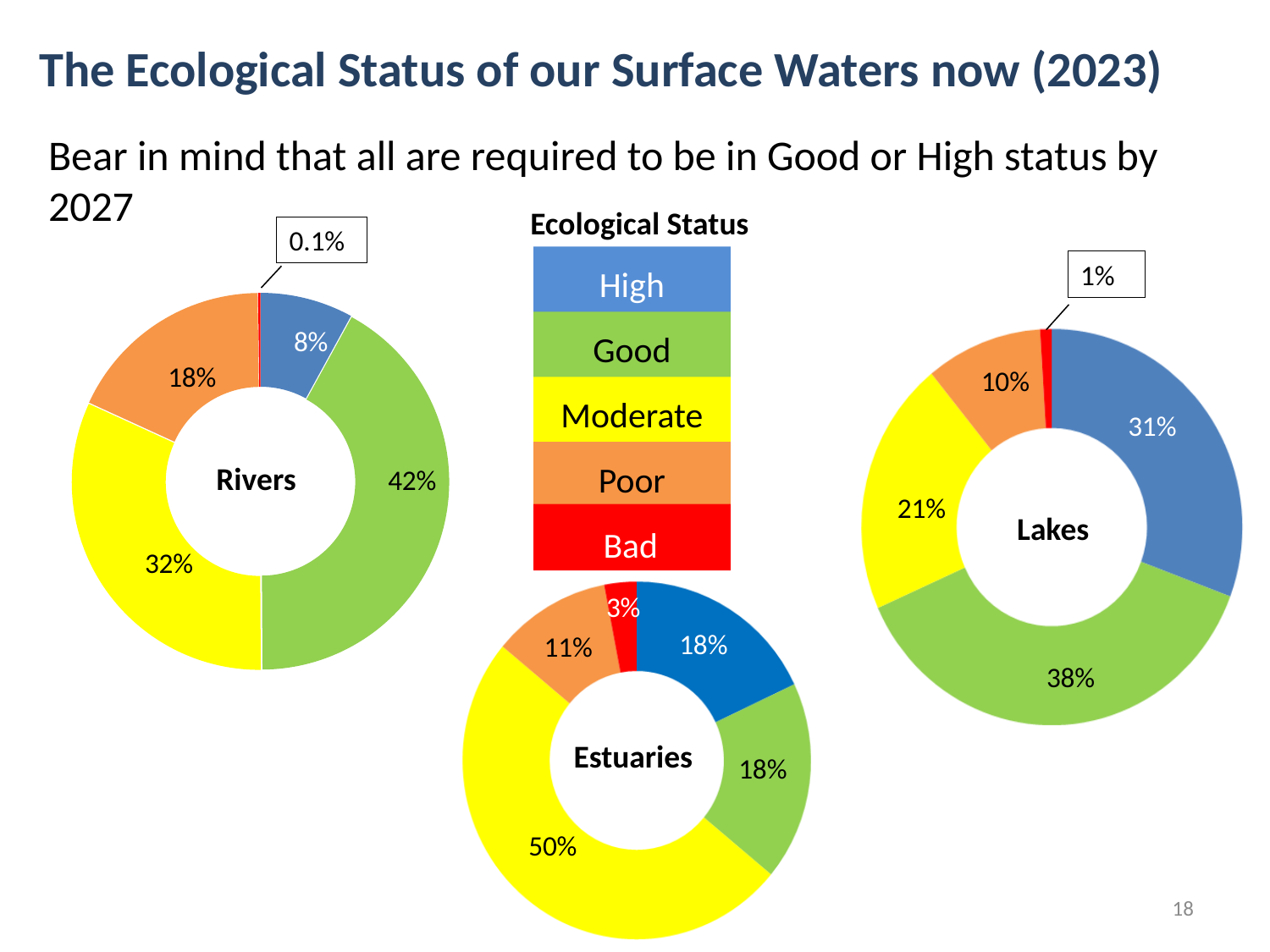
How many ecological status categories does the legend list? 5 In the Lakes chart, which ecological status category has the largest share? Good In the Estuaries chart, which ecological status category has the largest share? Moderate In the Rivers chart, what is the difference between the Good share and the Moderate share? 10% In the Lakes chart, what is the difference between the Good share and the High share? 7% In the Rivers chart, what percentage of rivers are in Bad ecological status? 0.1% In the Lakes chart, what percentage of lakes are in High ecological status? 31% In the Rivers chart, what percentage of rivers are in Good ecological status? 42% What type of chart is used to show the ecological status of Rivers, Lakes and Estuaries? Doughnut chart Which is larger: the Poor share in the Rivers chart or the Poor share in the Lakes chart? Rivers In the Estuaries chart, what percentage of estuaries are in Moderate ecological status? 50% In the Rivers chart, which ecological status category has the smallest share? Bad